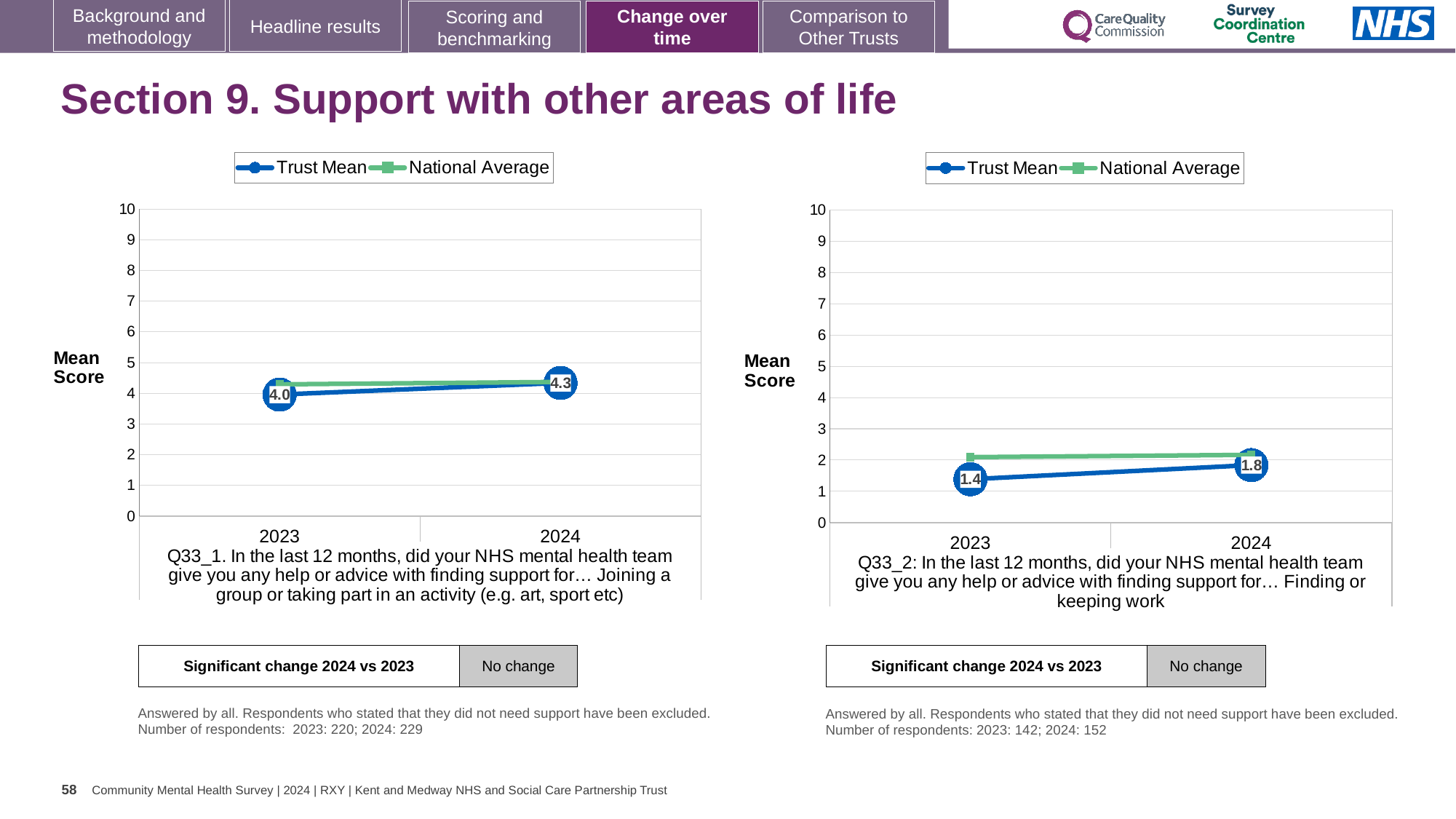
In the left chart (Q33_1), does the Trust Mean rise or fall from 2023 to 2024? rise In the left chart (Q33_1), what is the Trust Mean score for 2024? 4.3 In the right chart (Q33_2), does the Trust Mean rise or fall from 2023 to 2024? rise In the right chart (Q33_2), which is larger in 2023: the Trust Mean or the National Average? National Average In the right chart (Q33_2), what is the Trust Mean score for 2024? 1.8 In the left chart (Q33_1), by how much did the Trust Mean change from 2023 to 2024? 0.3 In the left chart (Q33_1), what is the Trust Mean score for 2023? 4.0 What type of chart is the left chart (Q33_1)? line chart In the right chart (Q33_2), what is the Trust Mean score for 2023? 1.4 How many series does the legend of the right chart (Q33_2) list? 2 In the right chart (Q33_2), by how much did the Trust Mean change from 2023 to 2024? 0.4